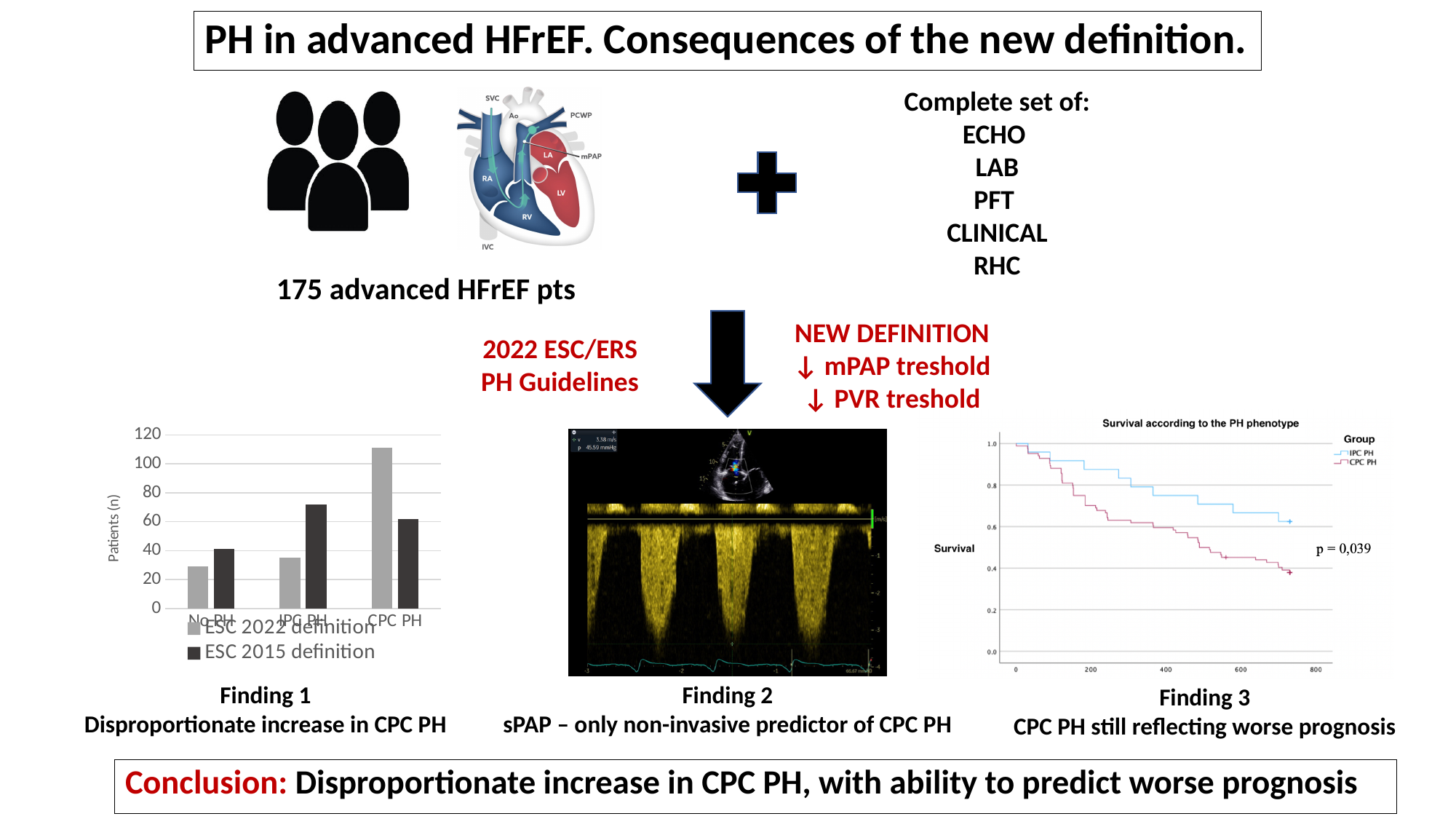
On the bar chart under Finding 1, what kind of chart is it? bar chart On the bar chart under Finding 1, how many categories are shown on the x axis? 3 On the survival chart under Finding 3, how many groups does the legend list? 2 On the bar chart under Finding 1, which category has the highest ESC 2022 definition bar? CPC PH On the bar chart under Finding 1, is the ESC 2015 definition value for IPC PH greater or less than 60? greater On the bar chart under Finding 1, which category has the highest ESC 2015 definition bar? IPC PH On the bar chart under Finding 1, for CPC PH, which series has the larger value: ESC 2022 definition or ESC 2015 definition? ESC 2022 definition On the bar chart under Finding 1, how many series does the legend list? 2 On the bar chart under Finding 1, is the ESC 2022 definition value for CPC PH greater or less than 100? greater On the bar chart under Finding 1, is the ESC 2022 definition value for No PH greater or less than 40? less On the bar chart under Finding 1, what is the label of the y axis? Patients (n) On the bar chart under Finding 1, which category has the lowest ESC 2022 definition bar? No PH